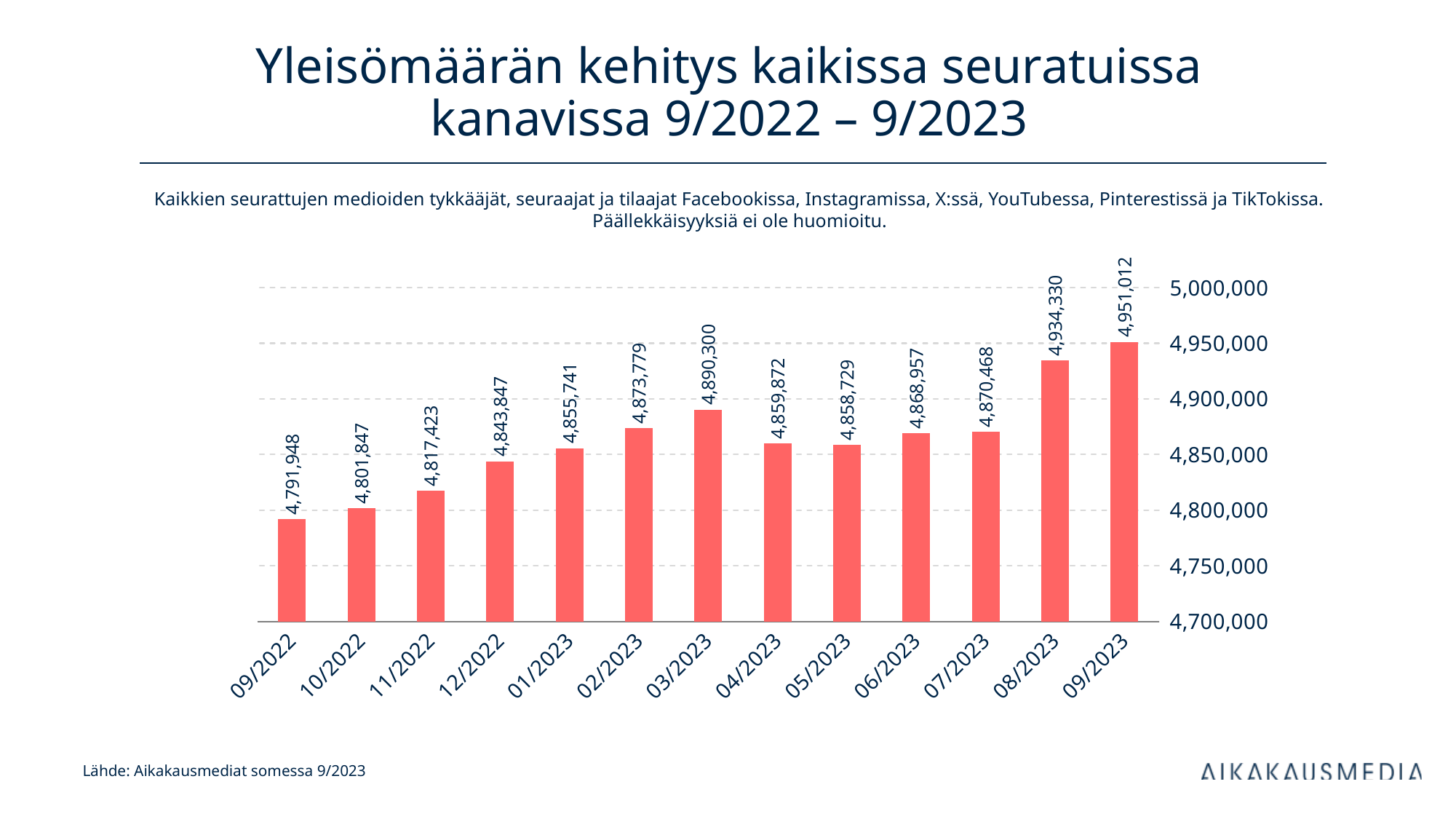
What is the value for 03/2023? 4,890,300 What type of chart is shown on the slide? Bar chart Is the value for 11/2022 greater or less than 4,800,000? greater What is the difference between the values for 09/2023 and 09/2022? 159,064 Which month has the lowest value? 09/2022 Which month has the highest value? 09/2023 Which is larger, the value for 03/2023 or the value for 06/2023? 03/2023 What is the source cited at the bottom of the slide? Aikakausmediat somessa 9/2023 How many months (bars) are plotted in the chart? 13 What is the difference between the values for 08/2023 and 07/2023? 63,862 What is the value for 09/2022? 4,791,948 What is the value for 08/2023? 4,934,330